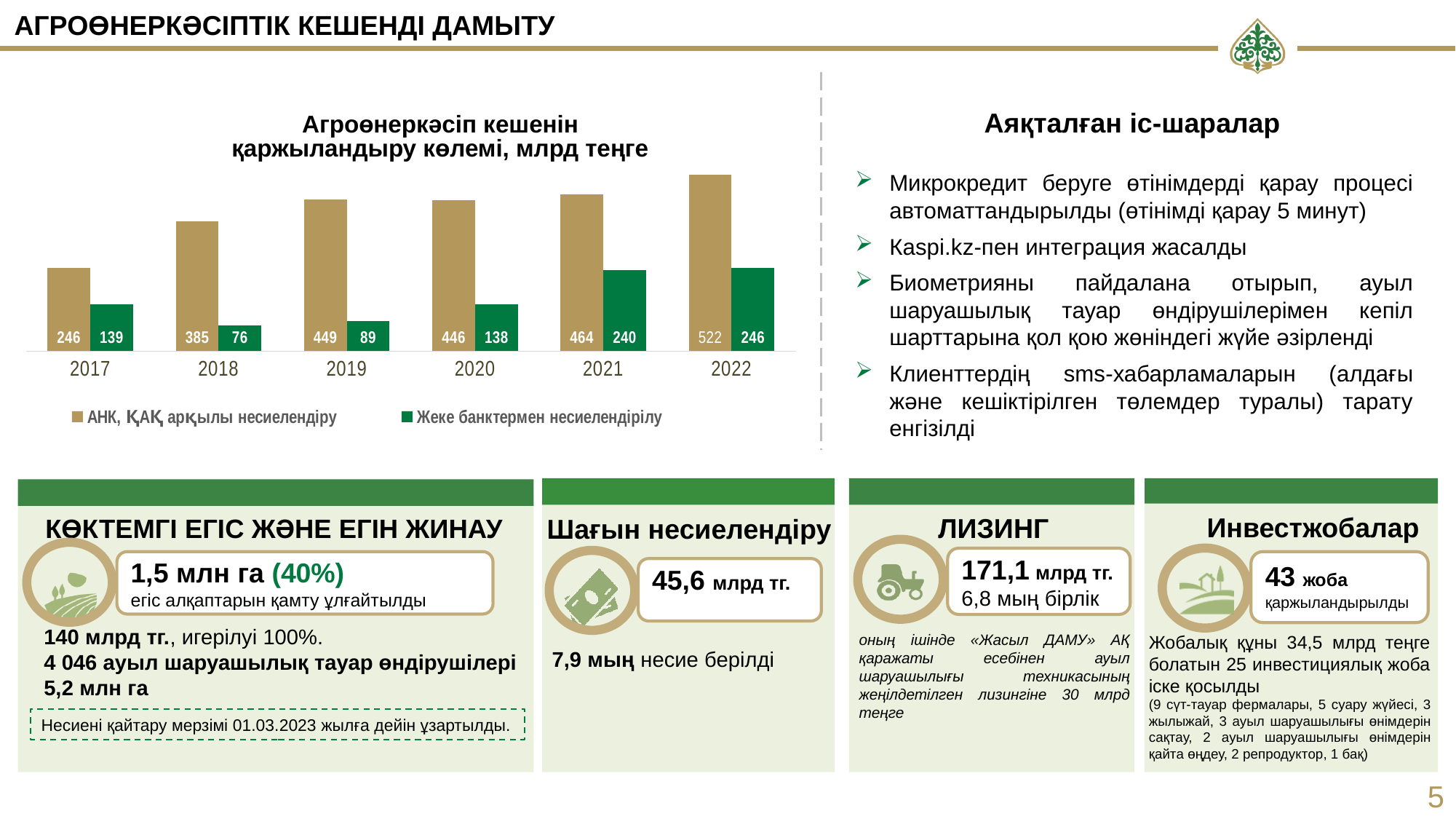
How many years are shown on the x axis of the chart? 6 Does the value for АНК, ҚАҚ арқылы несиелендіру rise or fall from 2017 to 2018? Rise What is the title of the chart? Агроөнеркәсіп кешенін қаржыландыру көлемі, млрд теңге In which year is the value for Жеке банктермен несиелендірілу the lowest? 2018 What kind of chart is shown on the slide? Bar chart What is the value for АНК, ҚАҚ арқылы несиелендіру in 2019? 449 Which is larger: the Жеке банктермен несиелендірілу value in 2017 or in 2020? 2017 In which year is the value for АНК, ҚАҚ арқылы несиелендіру the highest? 2022 What is the value for АНК, ҚАҚ арқылы несиелендіру in 2022? 522 How many series does the chart legend list? 2 What is the value for Жеке банктермен несиелендірілу in 2018? 76 What is the difference between the АНК, ҚАҚ арқылы несиелендіру value and the Жеке банктермен несиелендірілу value in 2021? 224